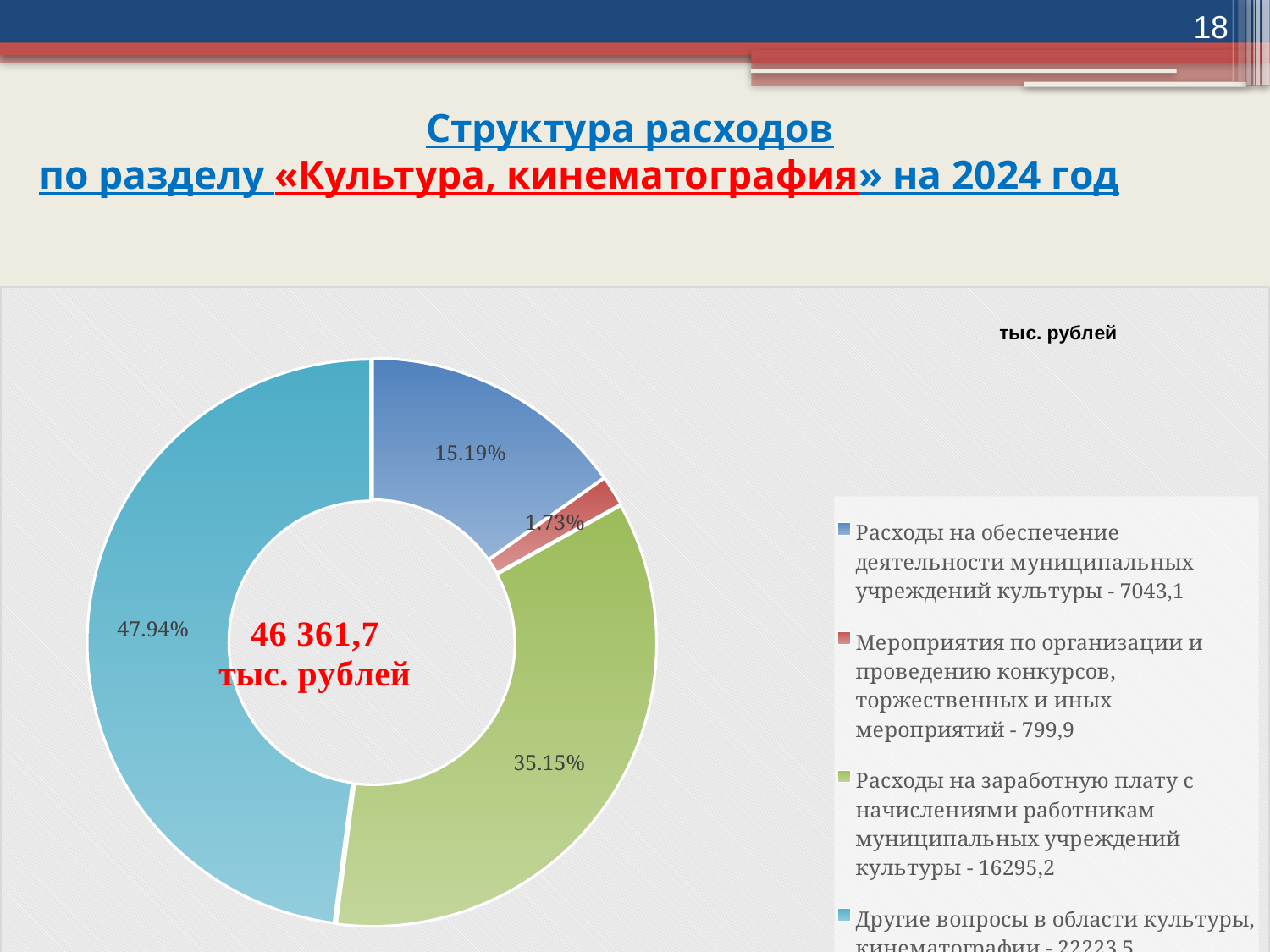
Which category has the largest share of the doughnut chart? Другие вопросы в области культуры, кинематографии According to the legend, what is the amount (тыс. рублей) for «Расходы на заработную плату с начислениями работникам муниципальных учреждений культуры»? 16295,2 Which is larger: the share for «Расходы на заработную плату...» or the share for «Расходы на обеспечение деятельности муниципальных учреждений культуры»? Расходы на заработную плату с начислениями работникам муниципальных учреждений культуры What share of expenses is shown for «Мероприятия по организации и проведению конкурсов, торжественных и иных мероприятий»? 1.73% What kind of chart is shown on the slide? Doughnut (pie) chart How many slices does the doughnut chart have? 4 What share of expenses is shown for «Расходы на обеспечение деятельности муниципальных учреждений культуры»? 15.19% According to the legend, what is the amount (тыс. рублей) for «Расходы на обеспечение деятельности муниципальных учреждений культуры»? 7043,1 Which category has the smallest share of the doughnut chart? Мероприятия по организации и проведению конкурсов, торжественных и иных мероприятий What share of expenses is shown for «Расходы на заработную плату с начислениями работникам муниципальных учреждений культуры»? 35.15% What total amount is shown in the centre of the doughnut chart? 46 361,7 тыс. рублей